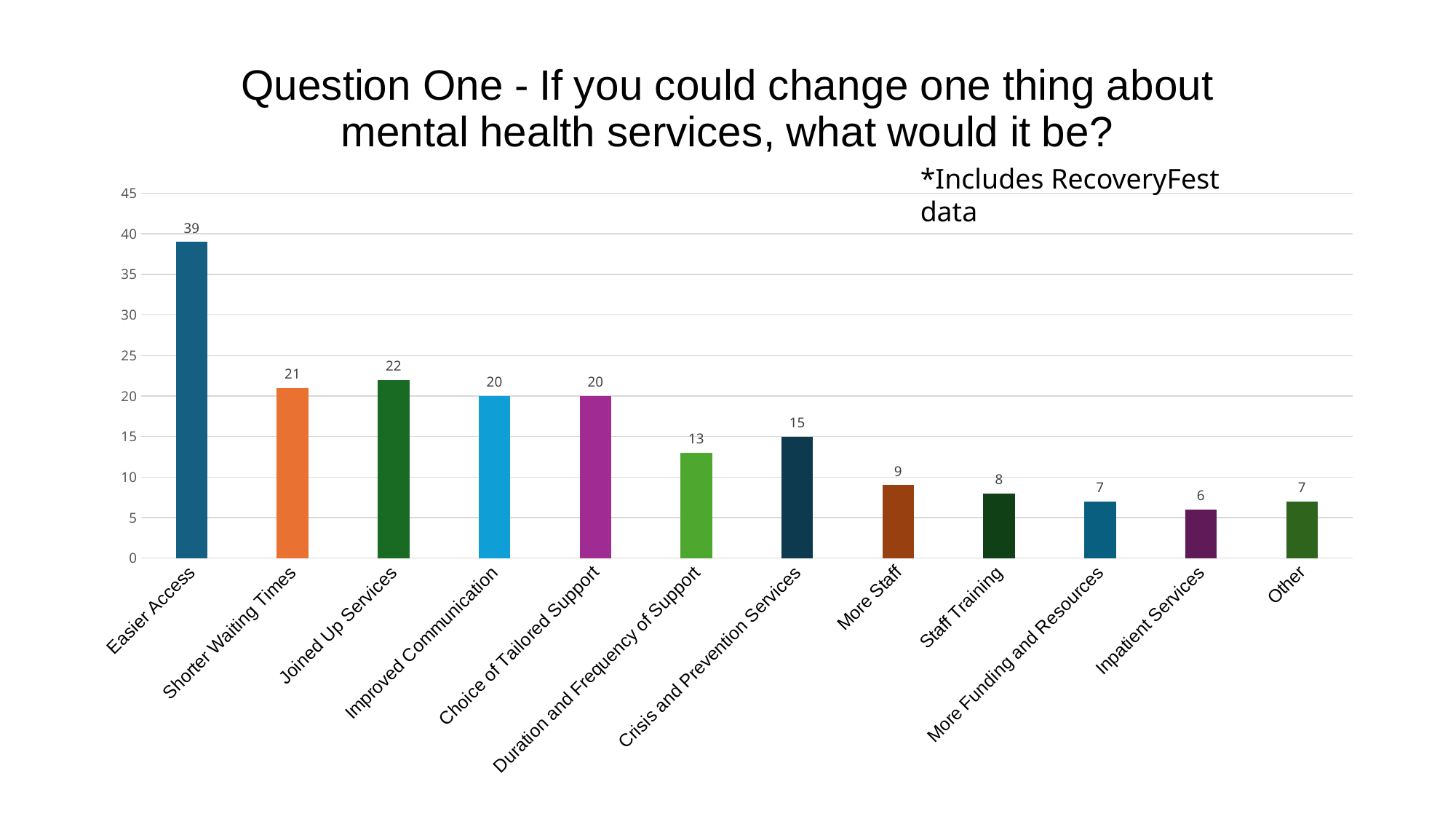
What note appears in the top right of the chart area? *Includes RecoveryFest data What is the difference between the values for Easier Access and Joined Up Services? 17 What kind of chart is shown on the slide? bar chart Which category has the lowest value? Inpatient Services What is the value for Crisis and Prevention Services? 15 What is the value for Inpatient Services? 6 Do the values generally rise or fall from left to right along the x axis? fall Which is larger, the value for Shorter Waiting Times or the value for Joined Up Services? Joined Up Services What is the value for Easier Access? 39 How many categories are shown on the x axis? 12 Is the value for Duration and Frequency of Support greater or less than 15? less Which category has the highest value? Easier Access